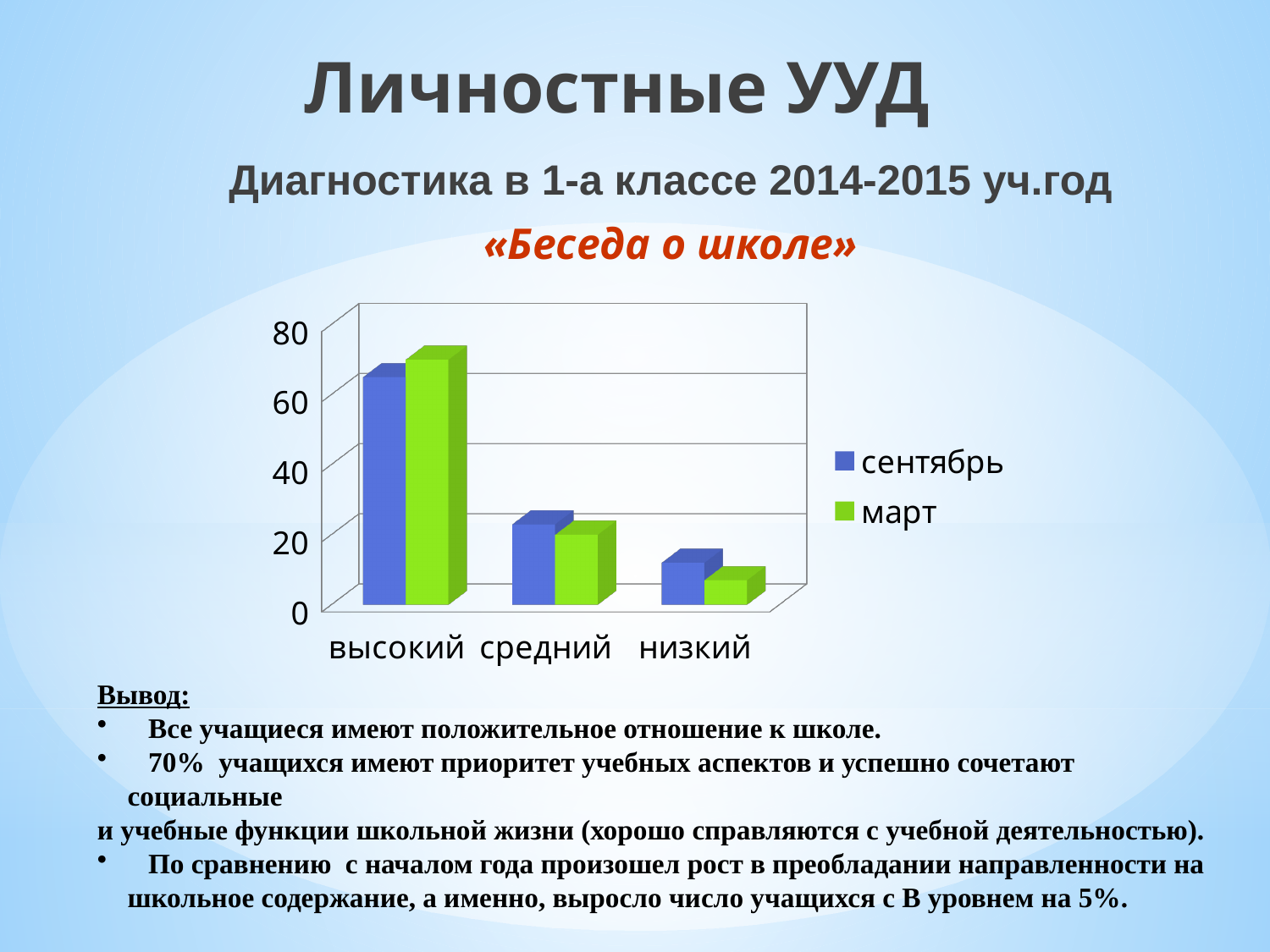
Which category has the lowest value for the сентябрь series? низкий Is the value for март in the низкий category greater or less than 20? less Is the value for сентябрь in the средний category greater or less than 40? less For the высокий category, which series has the larger value, сентябрь or март? март Do the values for the сентябрь series rise or fall moving from высокий to низкий along the x axis? fall Which category has the highest value for the март series? высокий For the средний category, which series has the larger value, сентябрь or март? сентябрь How many series does the chart legend list? 2 Is the value for март in the высокий category greater or less than 60? greater For the низкий category, which series has the larger value, сентябрь or март? сентябрь How many categories are shown on the x axis of the chart? 3 What kind of chart is shown on the slide? bar chart